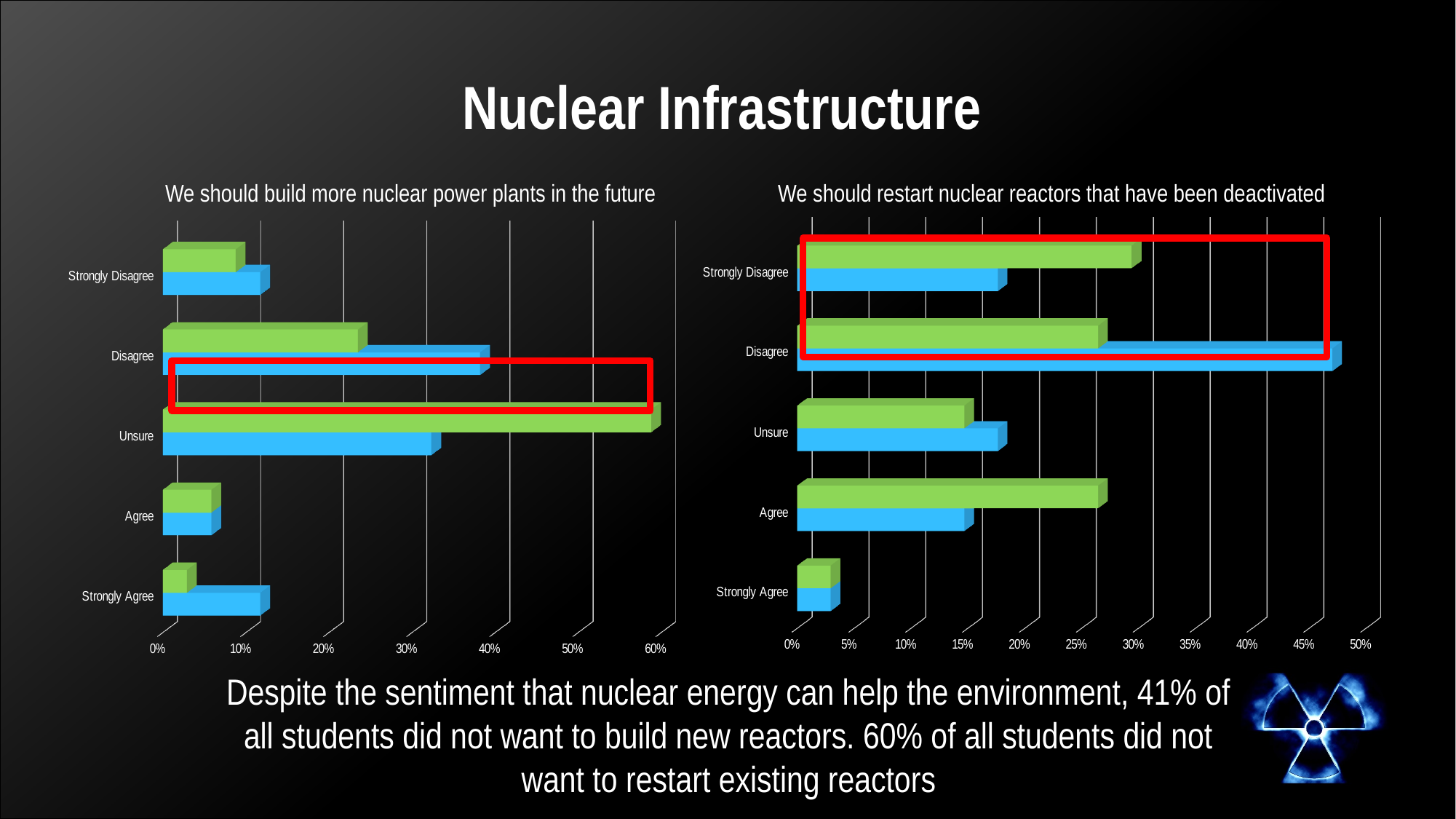
What is the title of the slide containing the two charts? Nuclear Infrastructure In the chart titled "We should restart nuclear reactors that have been deactivated", is the green bar for Agree longer or shorter than the blue bar for Agree? longer In the chart titled "We should build more nuclear power plants in the future", is the green bar for Unsure greater or less than 50%? greater In the chart titled "We should build more nuclear power plants in the future", which category has the longest green bar? Unsure What kind of chart is the chart titled "We should build more nuclear power plants in the future"? Bar chart In the chart titled "We should build more nuclear power plants in the future", which category has the longest blue bar? Disagree In the chart titled "We should restart nuclear reactors that have been deactivated", is the blue bar for Disagree greater or less than 40%? greater How many response categories are shown on the chart titled "We should restart nuclear reactors that have been deactivated"? 5 In the chart titled "We should restart nuclear reactors that have been deactivated", which category has the longest blue bar? Disagree In the chart titled "We should restart nuclear reactors that have been deactivated", which category has the shortest bars? Strongly Agree In the chart titled "We should build more nuclear power plants in the future", is the blue bar for Strongly Agree greater or less than 20%? less In the chart titled "We should build more nuclear power plants in the future", which category has the shortest green bar? Strongly Agree